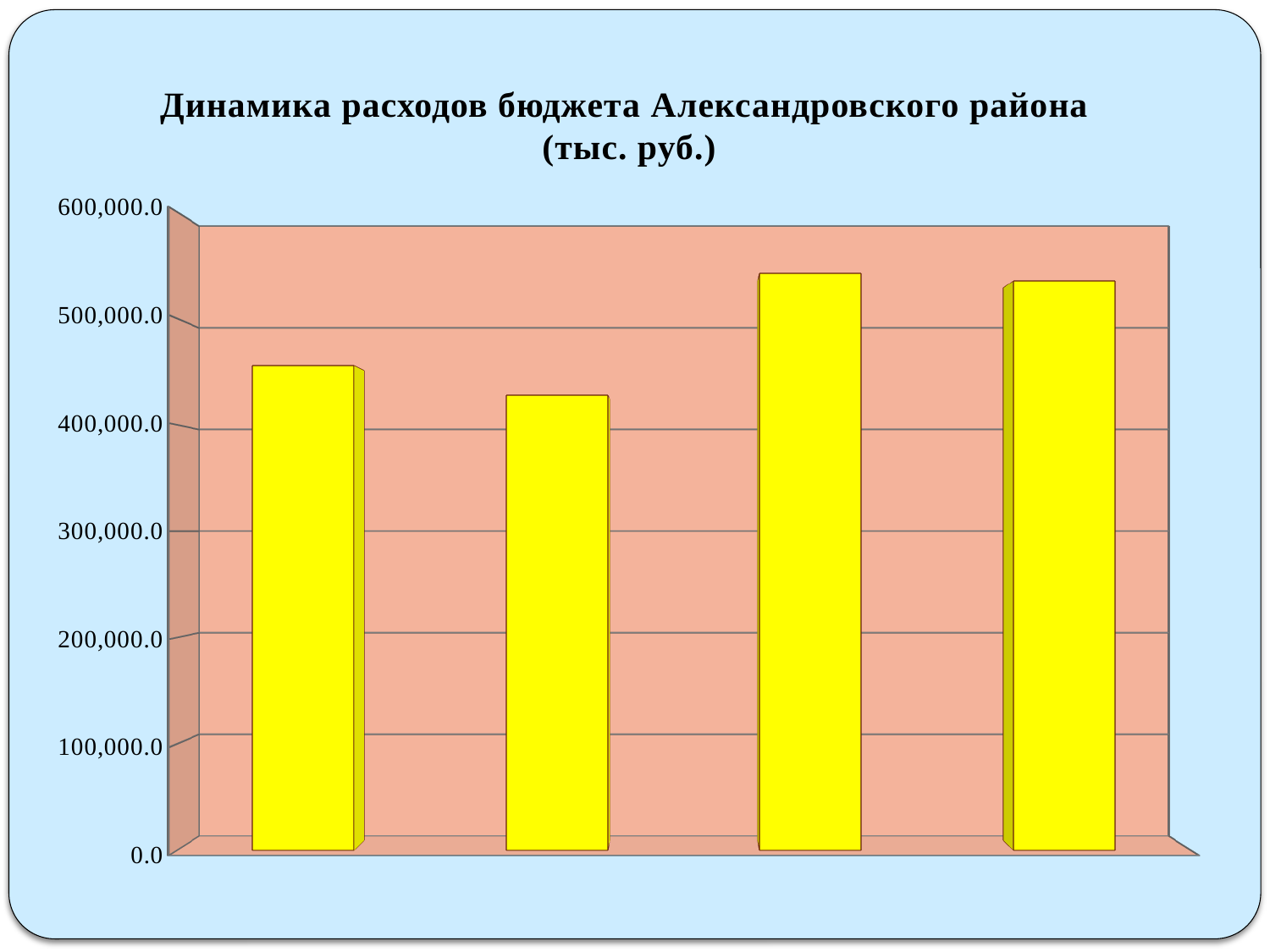
From the second bar to the third bar, does the value rise or fall? rise Is the value of the first (leftmost) bar greater or less than 400,000.0? greater Is the value of the fourth (rightmost) bar greater or less than 600,000.0? less Is the value of the second bar from the left greater or less than 500,000.0? less Which bar has the lowest value? the second bar from the left What kind of chart is shown on the slide? bar chart What is the title of the chart? Динамика расходов бюджета Александровского района (тыс. руб.) Which is larger, the first bar or the second bar? the first bar How many bars are plotted in the chart? 4 What unit is given in the chart title? тыс. руб.